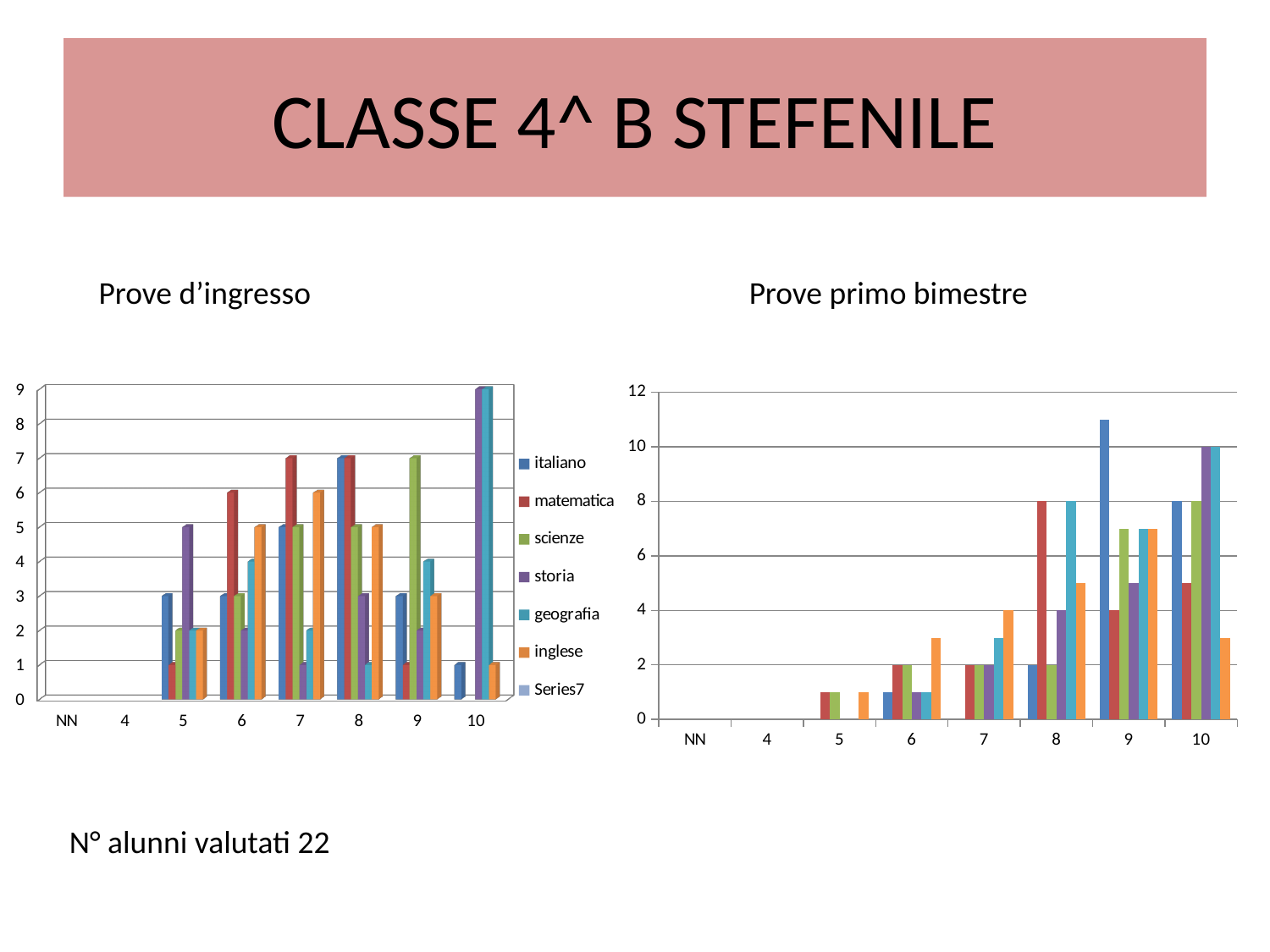
How many categories are shown on the x axis of the 'Prove d’ingresso' chart? 8 In the 'Prove primo bimestre' chart, what is the value of the blue (italiano) bar at category 10? 8 What is the last entry in the legend of the 'Prove d’ingresso' chart? Series7 In the 'Prove d’ingresso' chart, is the value for storia at category 5 greater or less than 4? greater In the 'Prove primo bimestre' chart, at category 8, which is larger: the red (matematica) bar or the blue (italiano) bar? matematica In the 'Prove primo bimestre' chart, is the tallest bar at category 9 greater or less than 10? greater In the 'Prove d’ingresso' chart, is the value for matematica at category 6 greater or less than 5? greater What kind of chart is the 'Prove primo bimestre' chart on the right? bar chart What kind of chart is the 'Prove d’ingresso' chart on the left? bar chart In the 'Prove primo bimestre' chart, what is the value of the purple (storia) bar at category 10? 10 How many categories are shown on the x axis of the 'Prove primo bimestre' chart? 8 How many series does the legend of the 'Prove d’ingresso' chart list? 7